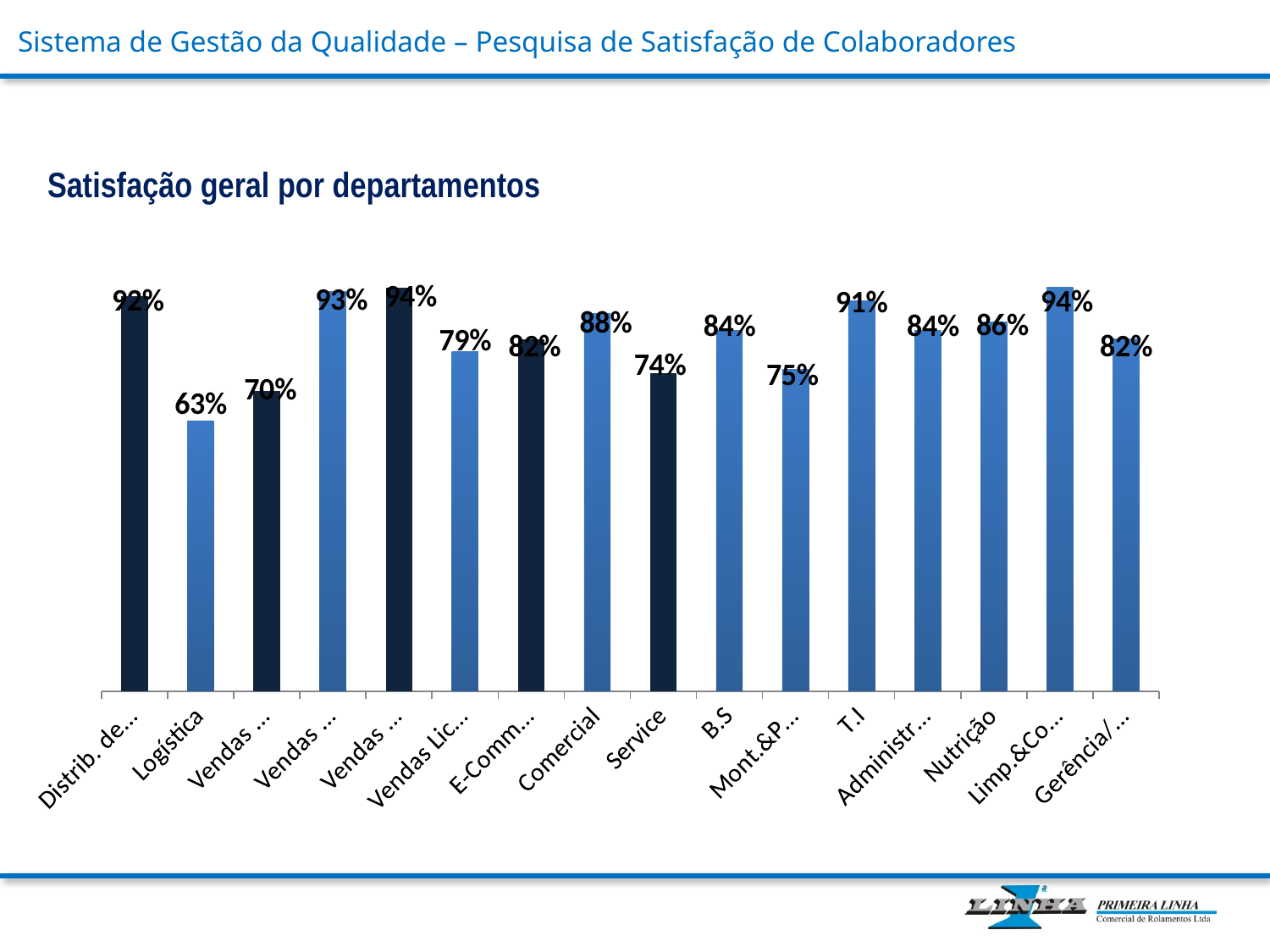
What is the satisfaction value for T.I? 91% How many bars are shown in the chart? 16 What is the satisfaction value for Logística? 63% What is the satisfaction value for Comercial? 88% Which department has the lowest satisfaction value? Logística What type of chart is shown on the slide? Bar chart What is the satisfaction value for Nutrição? 86% What is the satisfaction value for Service? 74% Which has a higher value, Nutrição or B.S? Nutrição What is the satisfaction value for B.S? 84% What is the difference between the values for Comercial and Service? 14 percentage points What is the difference between the values for T.I and Logística? 28 percentage points